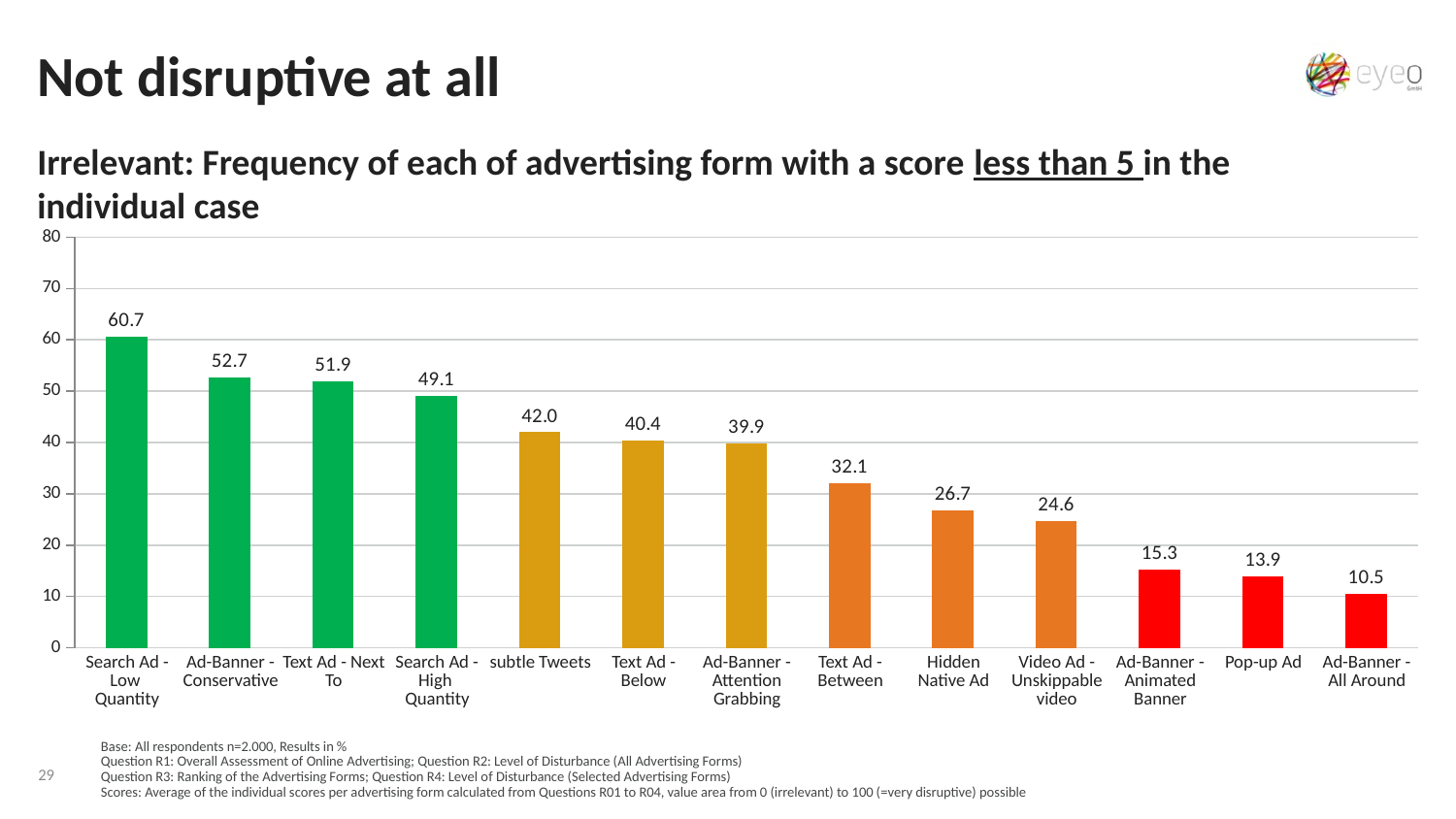
What kind of chart is shown on the slide? bar chart How many advertising forms are shown on the chart? 13 What is the value for Hidden Native Ad? 26.7 Which is larger, the value for Video Ad - Unskippable video or the value for Ad-Banner - Animated Banner? Video Ad - Unskippable video Which advertising form has the lowest value? Ad-Banner - All Around What is the difference between the values for Search Ad - Low Quantity and Ad-Banner - All Around? 50.2 Is the value for Text Ad - Below greater or less than 30? greater Do the values rise or fall from left to right along the x axis? fall What is the difference between the values for subtle Tweets and Text Ad - Between? 9.9 What is the value for Pop-up Ad? 13.9 What is the value for Search Ad - Low Quantity? 60.7 Which advertising form has the highest value? Search Ad - Low Quantity